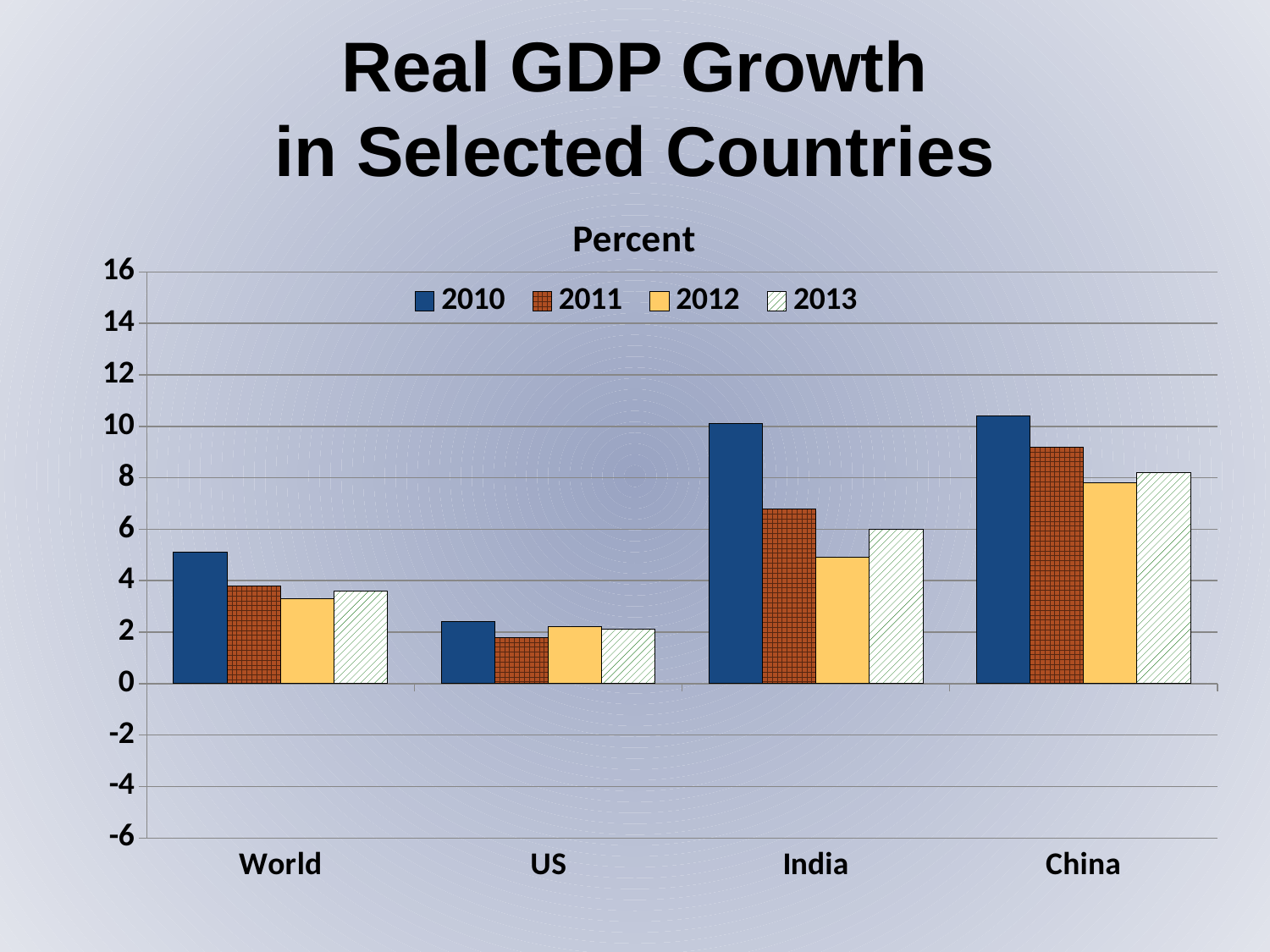
Which is larger for India: the 2011 value or the 2013 value? 2011 How many series does the legend list? 4 Which years are listed in the legend? 2010, 2011, 2012, 2013 Is the value for India in 2012 greater or less than 6? less What is the title of the chart? Percent Which country or region has the lowest value for 2010? US Is the value for China in 2011 greater or less than 8? greater Is the value for World in 2010 greater or less than 4? greater What kind of chart is shown on the slide? bar chart Do the values for India rise or fall from 2010 to 2012? fall How many countries or regions are shown on the x axis? 4 Which country or region has the highest value for 2011? China